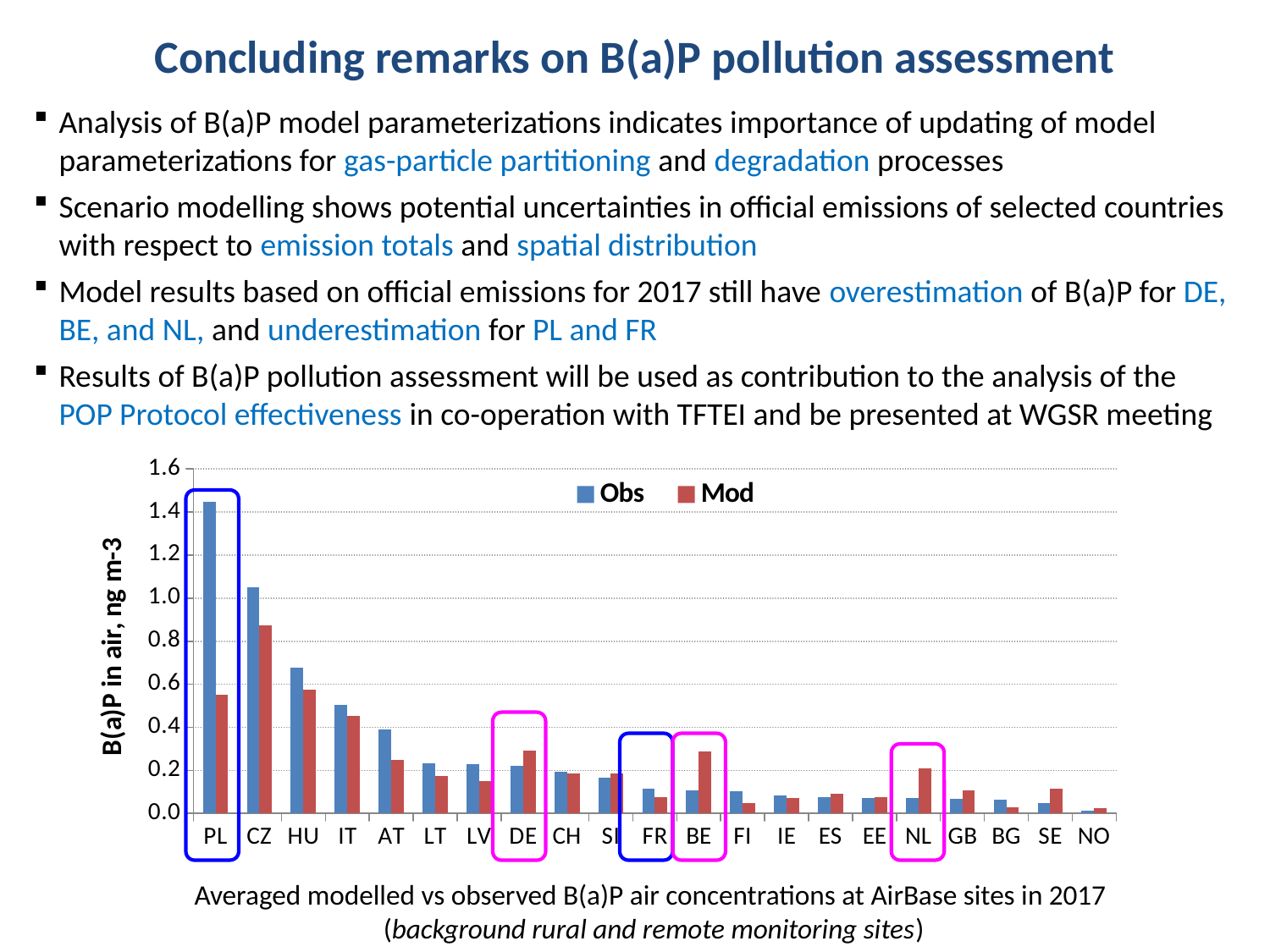
Do the Obs values generally rise or fall moving from left to right along the x axis? fall Which country has the highest Mod value in the chart? CZ How many countries are shown along the x axis of the chart? 21 What kind of chart is shown on the slide? bar chart For PL, which is larger, the Obs value or the Mod value? Obs Which country has the highest Obs value in the chart? PL Which country has the lowest Obs value in the chart? NO How many series does the chart legend list? 2 Is the Obs value for PL greater or less than 1.2? greater For DE, which is larger, the Obs value or the Mod value? Mod What are the two series named in the chart legend? Obs and Mod Is the Mod value for AT greater or less than 0.4? less